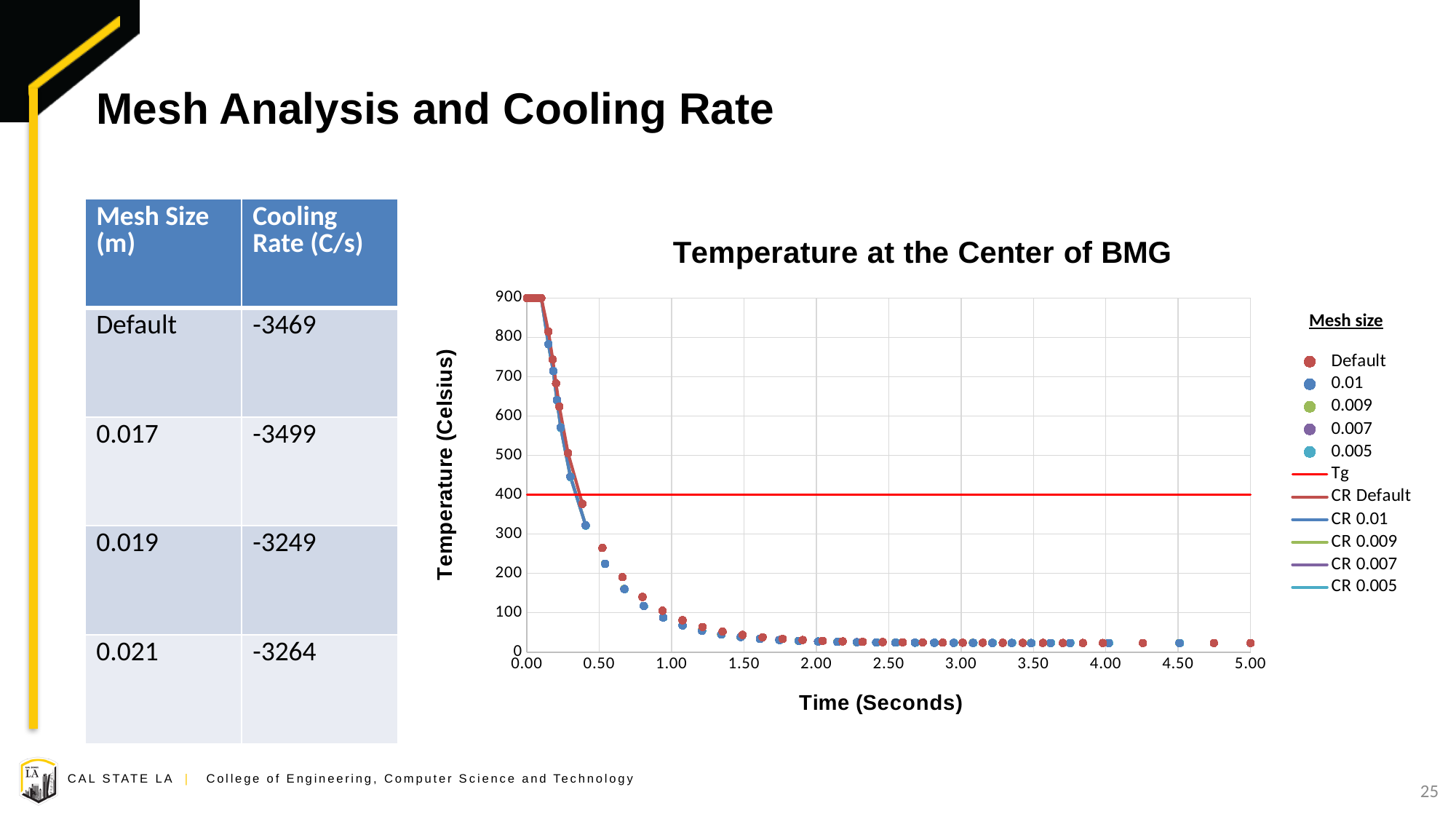
How many entries does the legend of the chart list? 11 Is the temperature at 1.00 seconds greater or less than 200? less What is the x-axis title of the chart? Time (Seconds) Is the temperature at 0.10 seconds greater or less than 800? greater What is the title of the chart? Temperature at the Center of BMG Does the temperature rise or fall as time increases along the x axis? fall What kind of chart is shown on the slide? scatter chart Is the temperature at 3.00 seconds greater or less than 100? less What is the temperature at time 0.00 seconds? 900 At what temperature is the horizontal Tg line drawn? 400